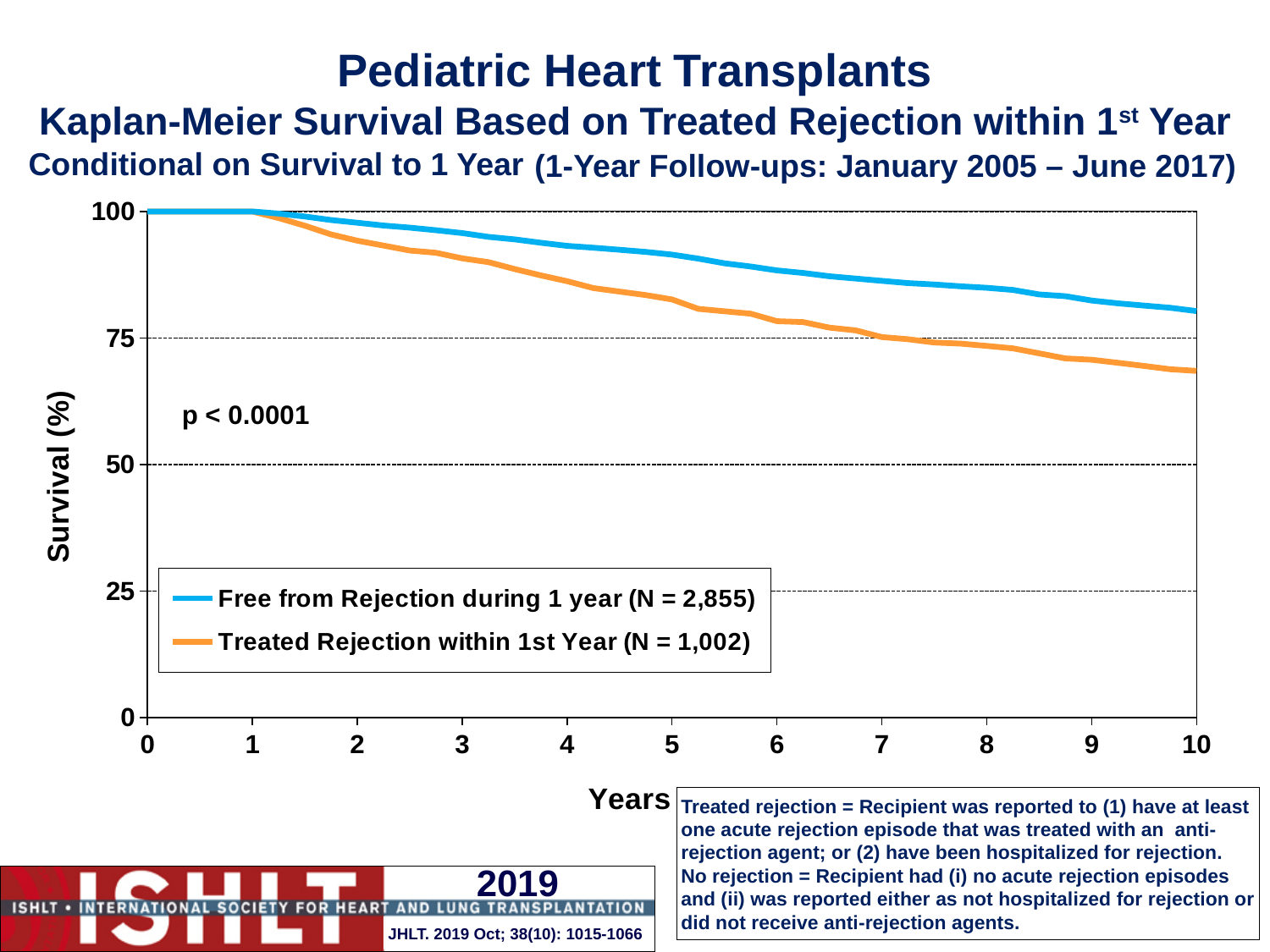
What is the N for the 'Treated Rejection within 1st Year' group shown in the legend? 1,002 Is the survival for the Treated Rejection within 1st Year group at 5 years greater or less than 75? greater What is the N for the 'Free from Rejection during 1 year' group shown in the legend? 2,855 How many series does the legend list? 2 Is the survival for the Treated Rejection within 1st Year group at 10 years greater or less than 75? less What is the label of the y axis? Survival (%) Is the survival for the Free from Rejection during 1 year group at 10 years greater or less than 75? greater Which colour represents the Treated Rejection within 1st Year group? Orange What kind of chart is shown on the slide? Line chart Which group has the higher survival at 10 years, Free from Rejection during 1 year or Treated Rejection within 1st Year? Free from Rejection during 1 year Do the survival curves rise or fall as years increase? Fall What p-value is printed on the chart? p < 0.0001